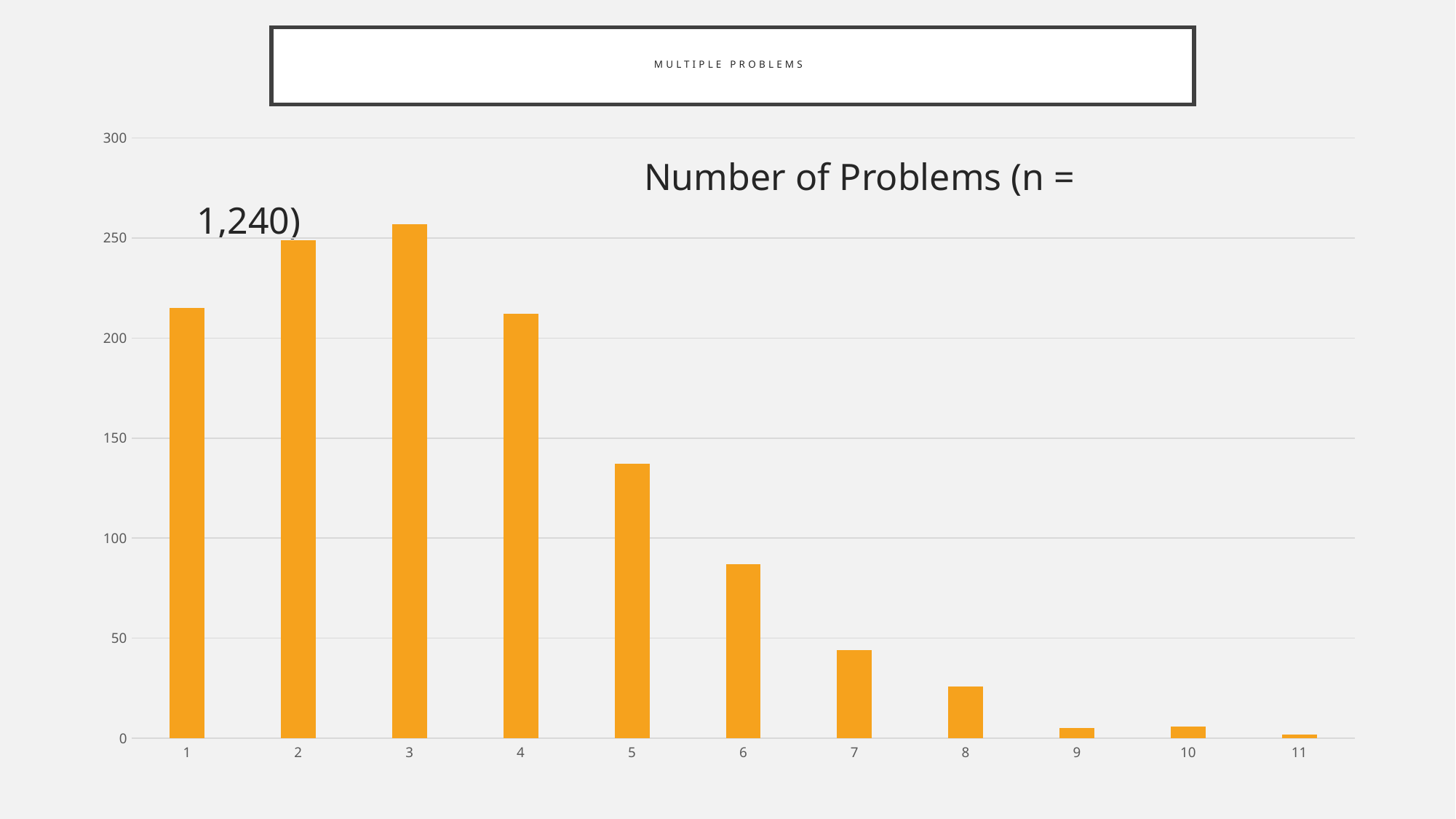
Which category has the highest bar in the chart? 3 Which has the larger value, category 2 or category 5? 2 Is the value for category 6 greater or less than 100? less What is the title of the chart? Number of Problems (n = 1,240) Is the value for category 2 greater or less than 200? greater How many categories are shown on the x axis of the chart? 11 Do the values rise or fall from category 3 to category 11? fall Which category has the lowest bar in the chart? 11 Is the value for category 1 greater or less than 200? greater What kind of chart is shown on the slide? bar chart